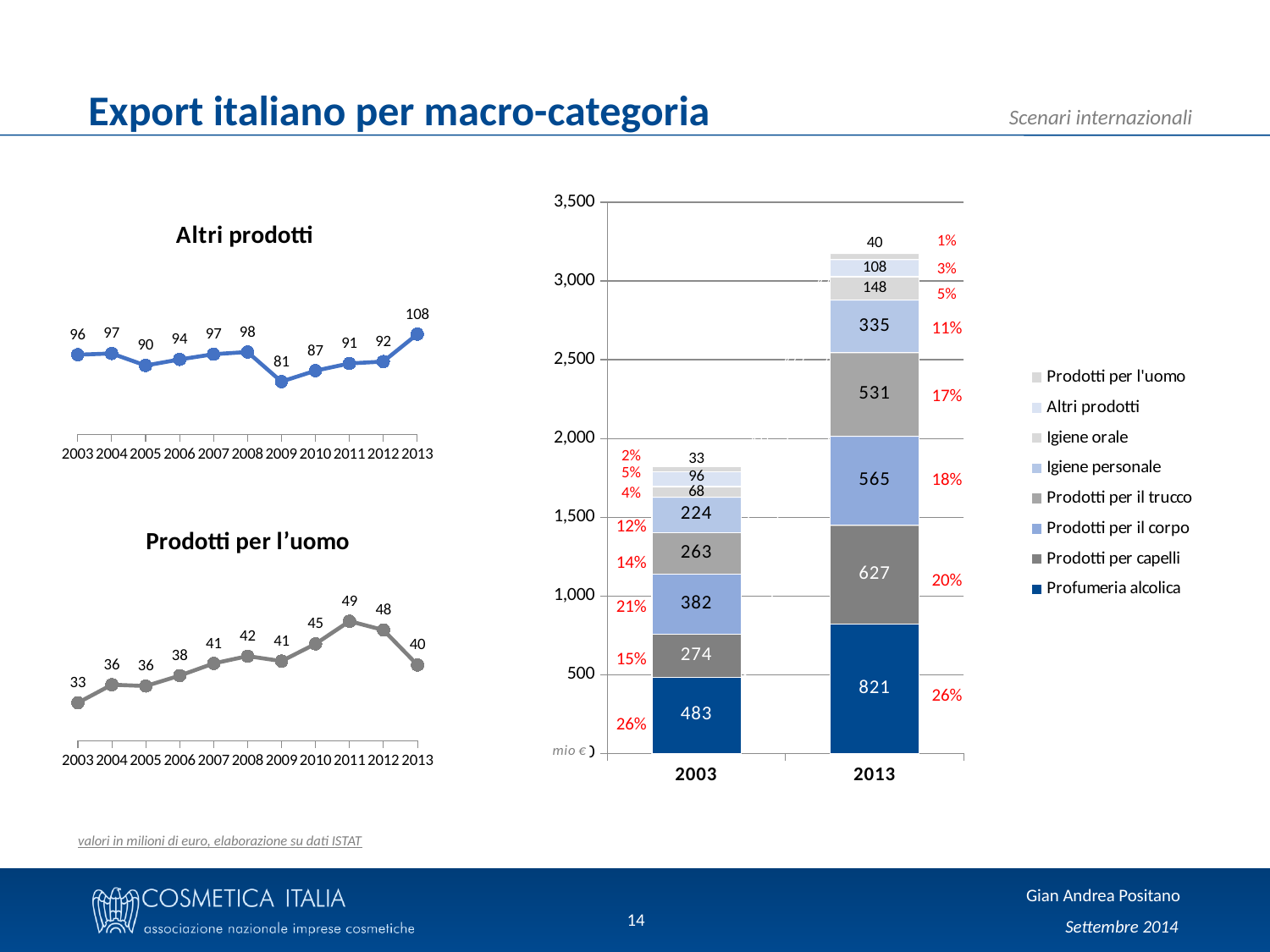
In the 'Prodotti per l'uomo' line chart, what is the difference between the 2011 value and the 2003 value? 16 In the stacked bar chart on the right, what percentage share is shown for Prodotti per il trucco in 2013? 17% In the stacked bar chart on the right, what is the value of Profumeria alcolica for 2013? 821 In the 'Altri prodotti' line chart, which year has the lowest value? 2009 In the 'Prodotti per l'uomo' line chart, how many data points are plotted? 11 In the 'Altri prodotti' line chart, what is the value for 2013? 108 In the stacked bar chart on the right, what is the value of Prodotti per il corpo for 2003? 382 In the stacked bar chart on the right, what is the difference between Prodotti per capelli in 2013 and in 2003? 353 In the stacked bar chart on the right, how many series does the legend list? 8 What type of chart is 'Altri prodotti'? Line chart In the 'Prodotti per l'uomo' line chart, which year has the highest value? 2011 In the stacked bar chart on the right, what is the total of the 2003 bar? 1,823